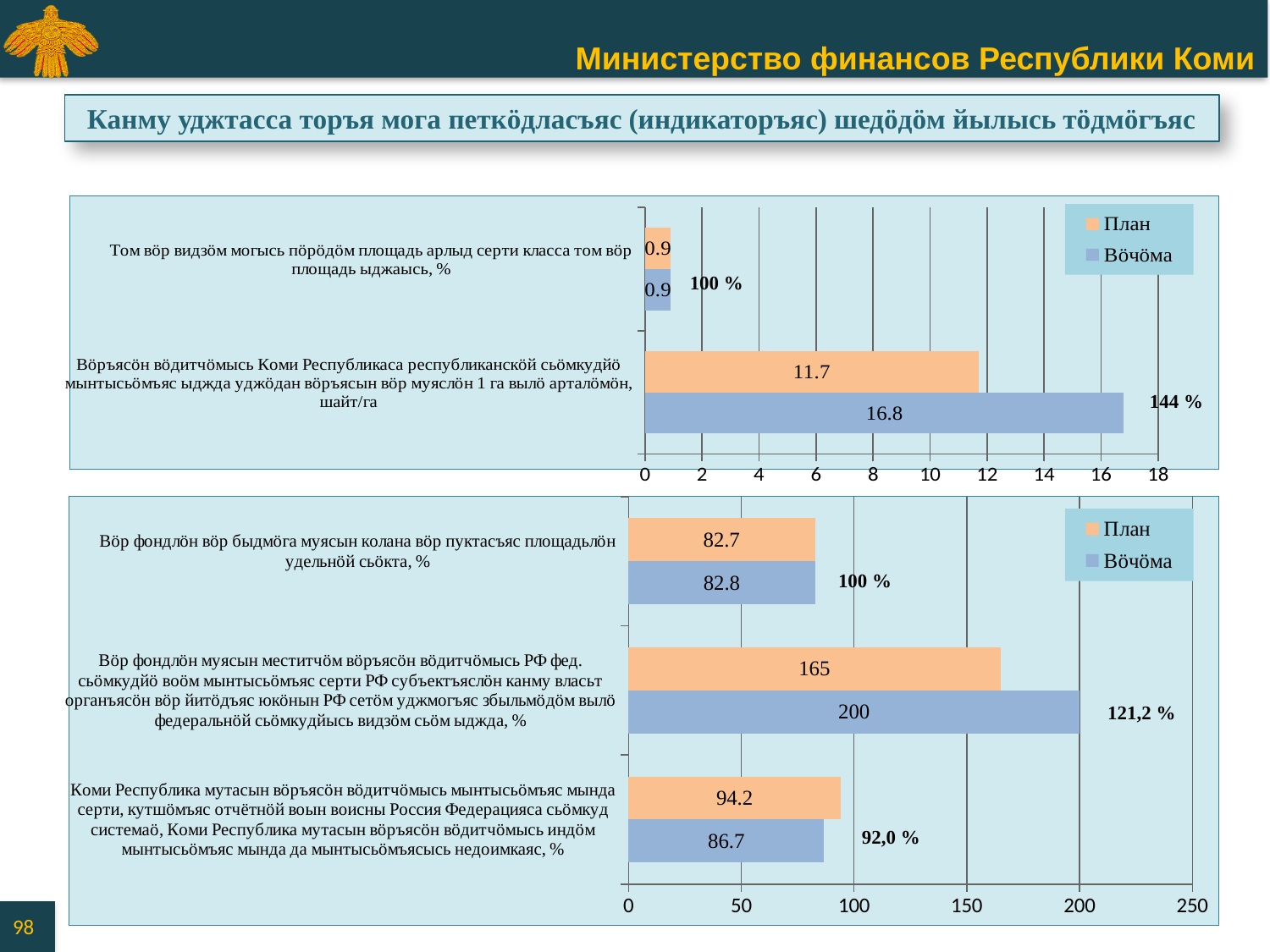
In the top chart, what percentage label is shown next to the bars for the category measured in шайт/га? 144 % How many series does the legend of the top chart list? 2 In the top chart, what is the difference between the Вöчöма and План values for the category measured in шайт/га? 5.1 In the top chart, what is the Вöчöма value for the category measured in шайт/га? 16.8 How many categories are plotted in the bottom chart? 3 In the bottom chart, which is larger for the category about Коми Республика мутасын вöръясöн вöдитчöмысь: План or Вöчöма? План What type of chart is the bottom chart? Bar chart In the bottom chart, what is the План value for the category about Коми Республика мутасын вöръясöн вöдитчöмысь мынтысьöмъяс мында? 94.2 In the top chart, what is the План value for the first category (Том вöр видзöм могысь пöрöдöм площадь...)? 0.9 In the bottom chart, what is the Вöчöма value for the category about вöр фондлöн муясын меститчöм вöръясöн вöдитчöмысь РФ фед. сьöмкудйö? 200 In the top chart, what is the План value for the category measured in шайт/га (Вöръясöн вöдитчöмысь Коми Республикаса...)? 11.7 In the bottom chart, which category has the highest Вöчöма value? Вöр фондлöн муясын меститчöм вöръясöн вöдитчöмысь РФ фед. сьöмкудйö воöм мынтысьöмъяс...